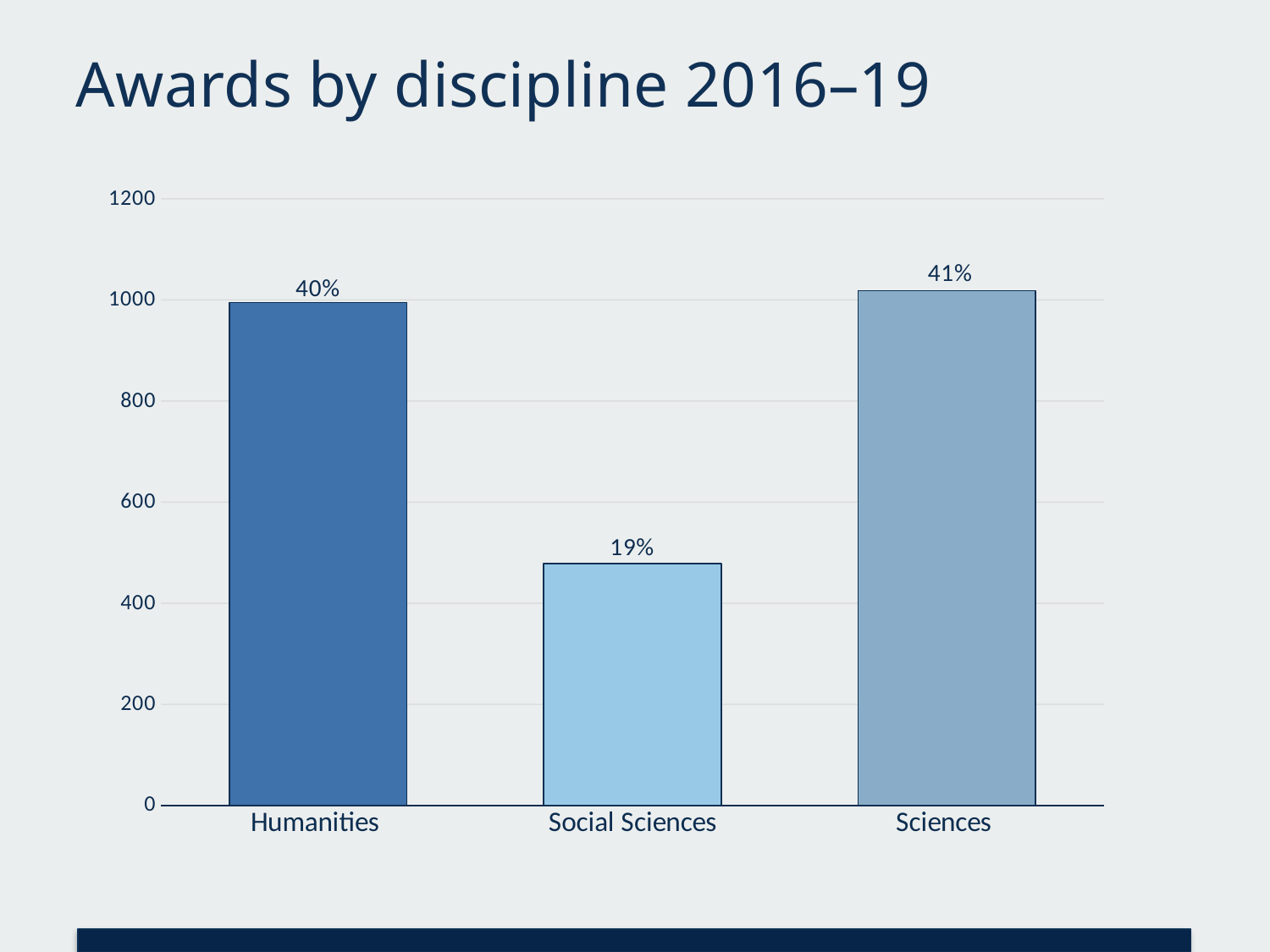
What percentage label is shown on the Social Sciences bar? 19% Which has the larger bar, Social Sciences or Humanities? Humanities Which has the higher percentage label, Humanities or Sciences? Sciences How many disciplines are shown on the chart? 3 Is the value for Social Sciences greater or less than 600? less What is the title of the slide? Awards by discipline 2016–19 What is the difference in percentage points between the Sciences label and the Social Sciences label? 22 percentage points What percentage label is shown on the Humanities bar? 40% What percentage label is shown on the Sciences bar? 41% What kind of chart is shown on the slide? bar chart Which discipline has the lowest number of awards? Social Sciences Is the value for Sciences greater or less than 800? greater